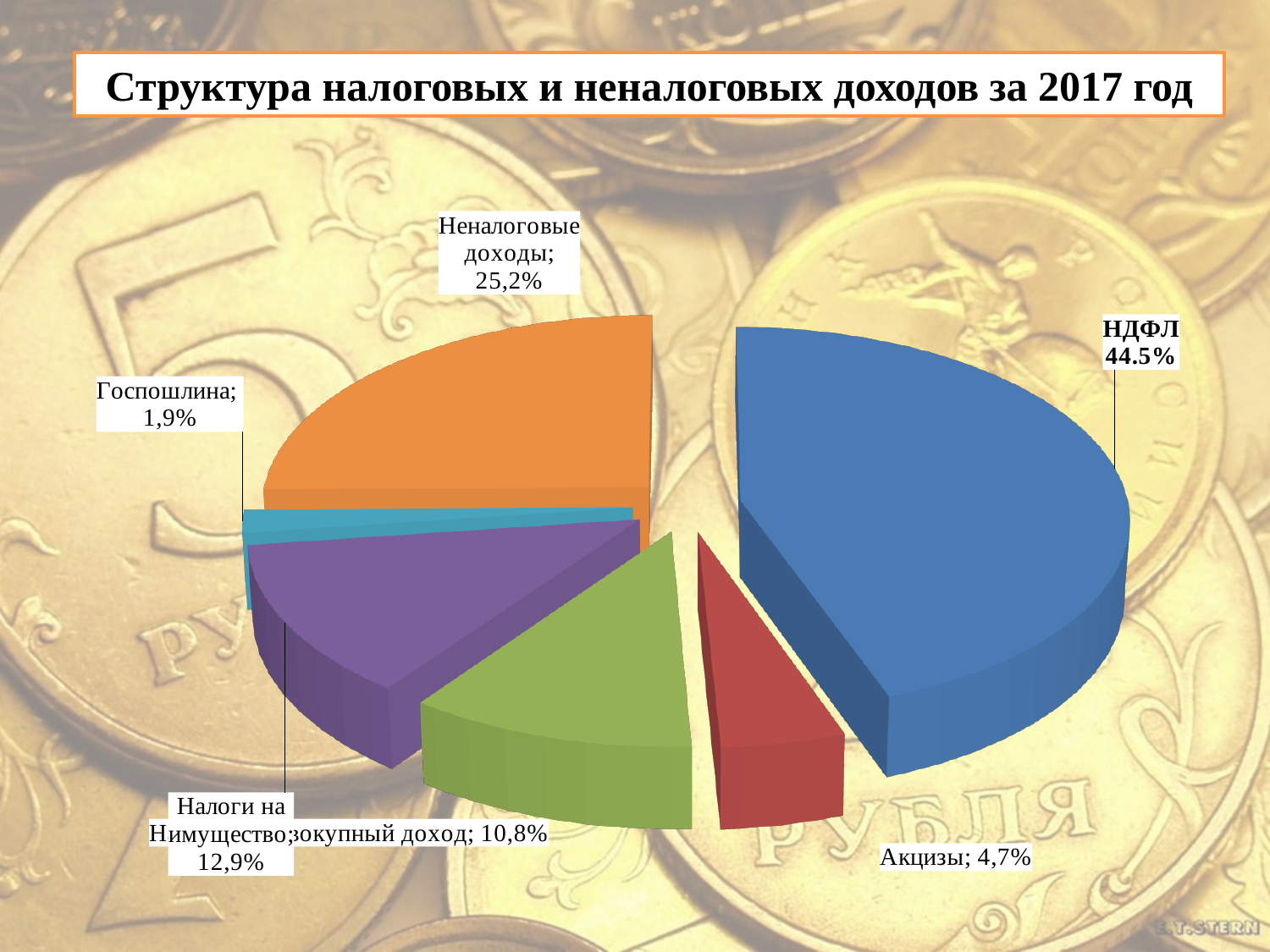
What kind of chart is shown on the slide? Pie chart How many slices does the pie chart have? 6 What is the value shown for Акцизы? 4,7% Which is larger, the share for Акцизы or the share for Госпошлина? Акцизы What is the value shown for Налоги на имущество? 12,9% What is the title of the chart? Структура налоговых и неналоговых доходов за 2017 год What is the value shown for Госпошлина? 1,9% Which category has the largest share of the pie? НДФЛ What is the value shown for Неналоговые доходы? 25,2% What is the difference between the shares for Неналоговые доходы and Налоги на имущество? 12,3 percentage points Which category has the smallest share of the pie? Госпошлина What share of the pie does НДФЛ have? 44.5%